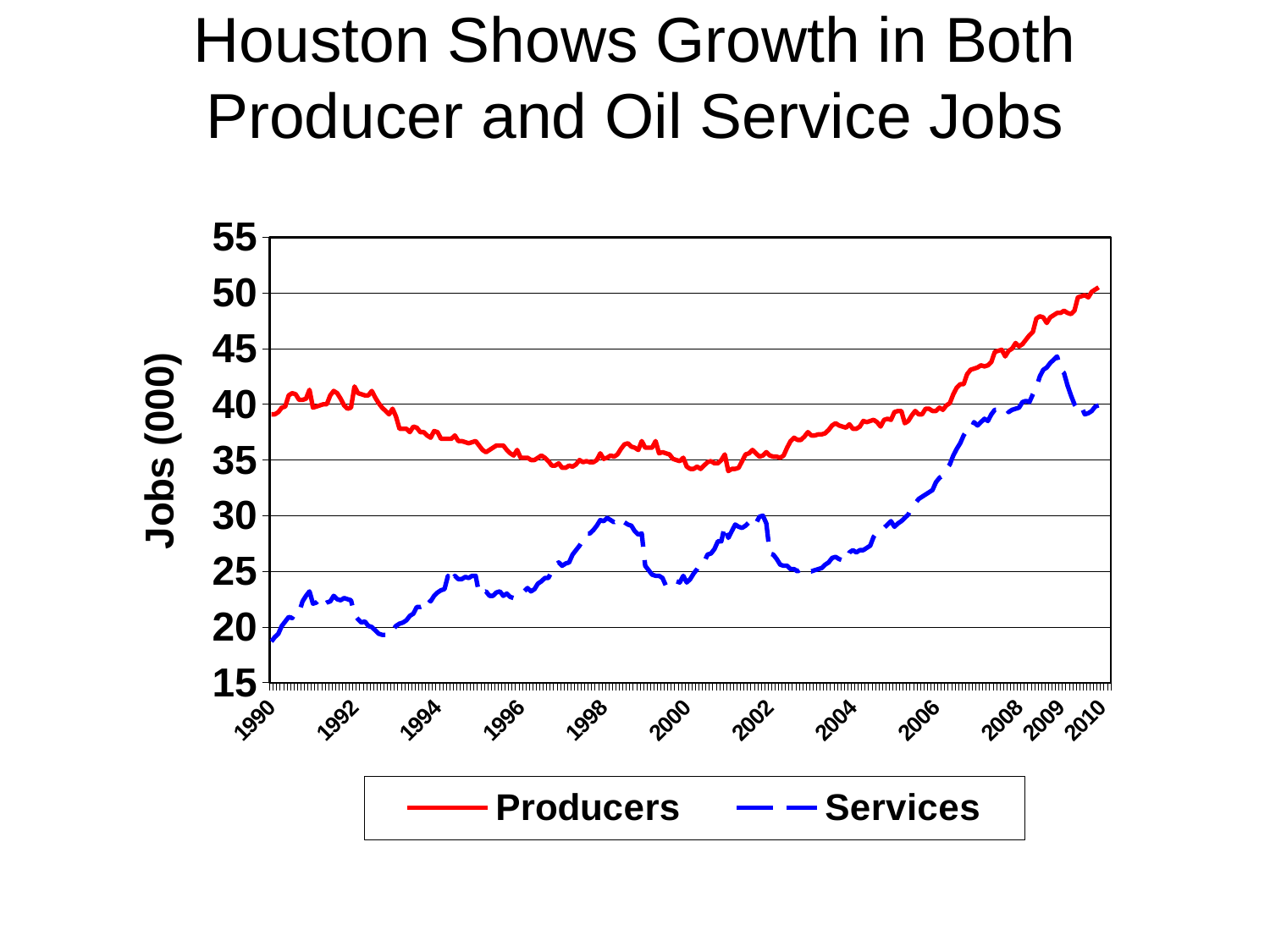
Is the value for Producers in 2010 greater or less than 45? greater Is the value for Producers in 1990 greater or less than 35? greater What kind of chart is shown on the slide? line chart Do the Producers values rise or fall between 2006 and 2010? rise Is the value for Services in 2003 greater or less than 30? less In 1990, which series has the higher value, Producers or Services? Producers What is the label on the vertical axis? Jobs (000) How many series does the legend list? 2 Which two series are listed in the legend? Producers and Services Which series reaches the highest value on the chart? Producers Which series is drawn with a dashed blue line? Services